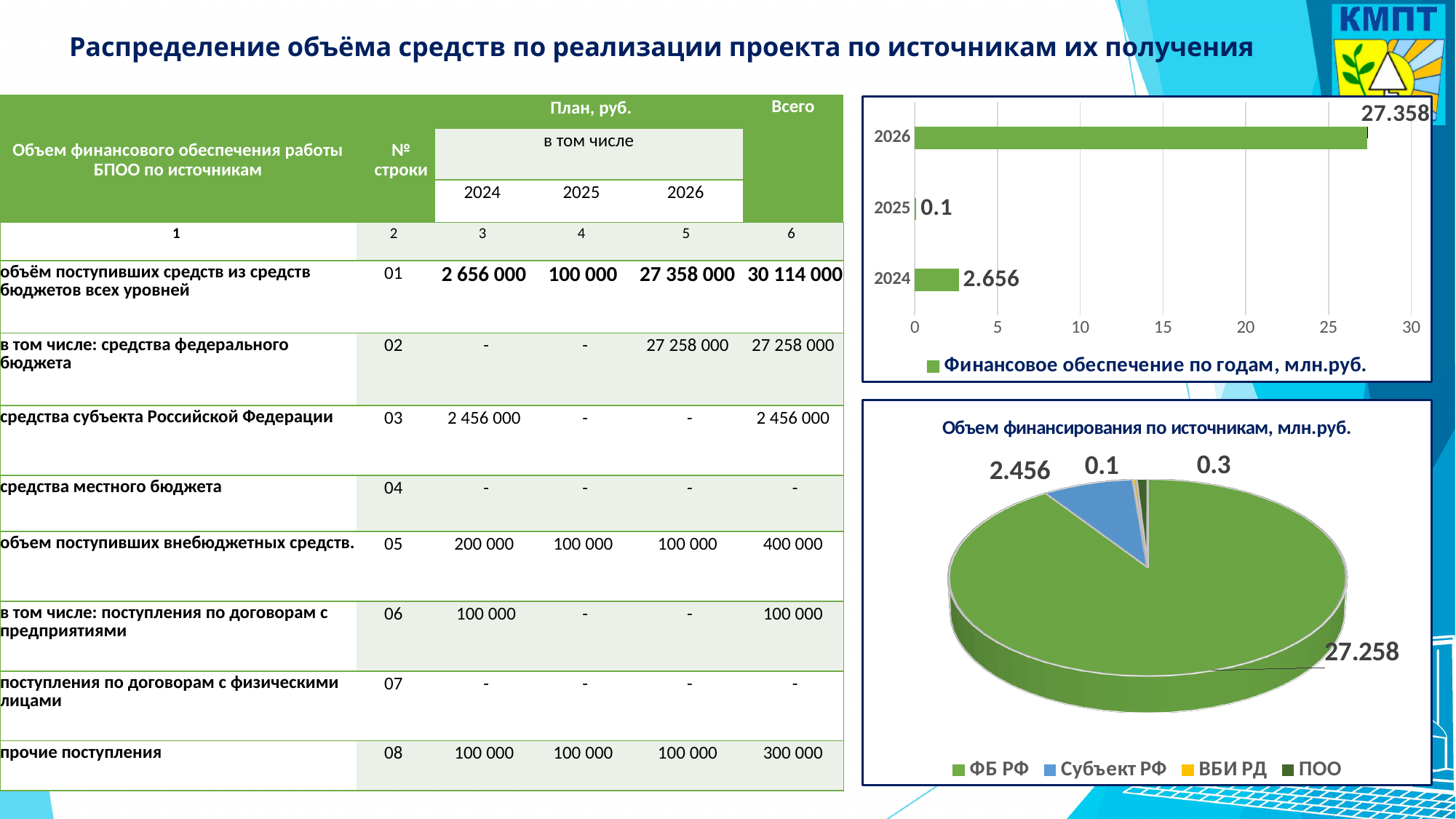
In the bar chart 'Финансовое обеспечение по годам, млн.руб.', which year has the lowest value? 2025 What type of chart is 'Финансовое обеспечение по годам, млн.руб.'? Bar chart In the bar chart 'Финансовое обеспечение по годам, млн.руб.', how many years are shown? 3 In the pie chart 'Объем финансирования по источникам, млн.руб.', which source has the largest slice? ФБ РФ In the pie chart 'Объем финансирования по источникам, млн.руб.', what is the value for Субъект РФ? 2.456 In the bar chart 'Финансовое обеспечение по годам, млн.руб.', what is the value for 2024? 2.656 How many entries does the legend of the pie chart 'Объем финансирования по источникам, млн.руб.' list? 4 In the bar chart 'Финансовое обеспечение по годам, млн.руб.', what is the difference between the 2026 and 2024 values? 24.702 In the pie chart 'Объем финансирования по источникам, млн.руб.', what is the value for ФБ РФ? 27.258 In the bar chart 'Финансовое обеспечение по годам, млн.руб.', what is the value for 2026? 27.358 In the pie chart 'Объем финансирования по источникам, млн.руб.', which is larger: ПОО or ВБИ РД? ПОО In the bar chart 'Финансовое обеспечение по годам, млн.руб.', which year has the highest value? 2026